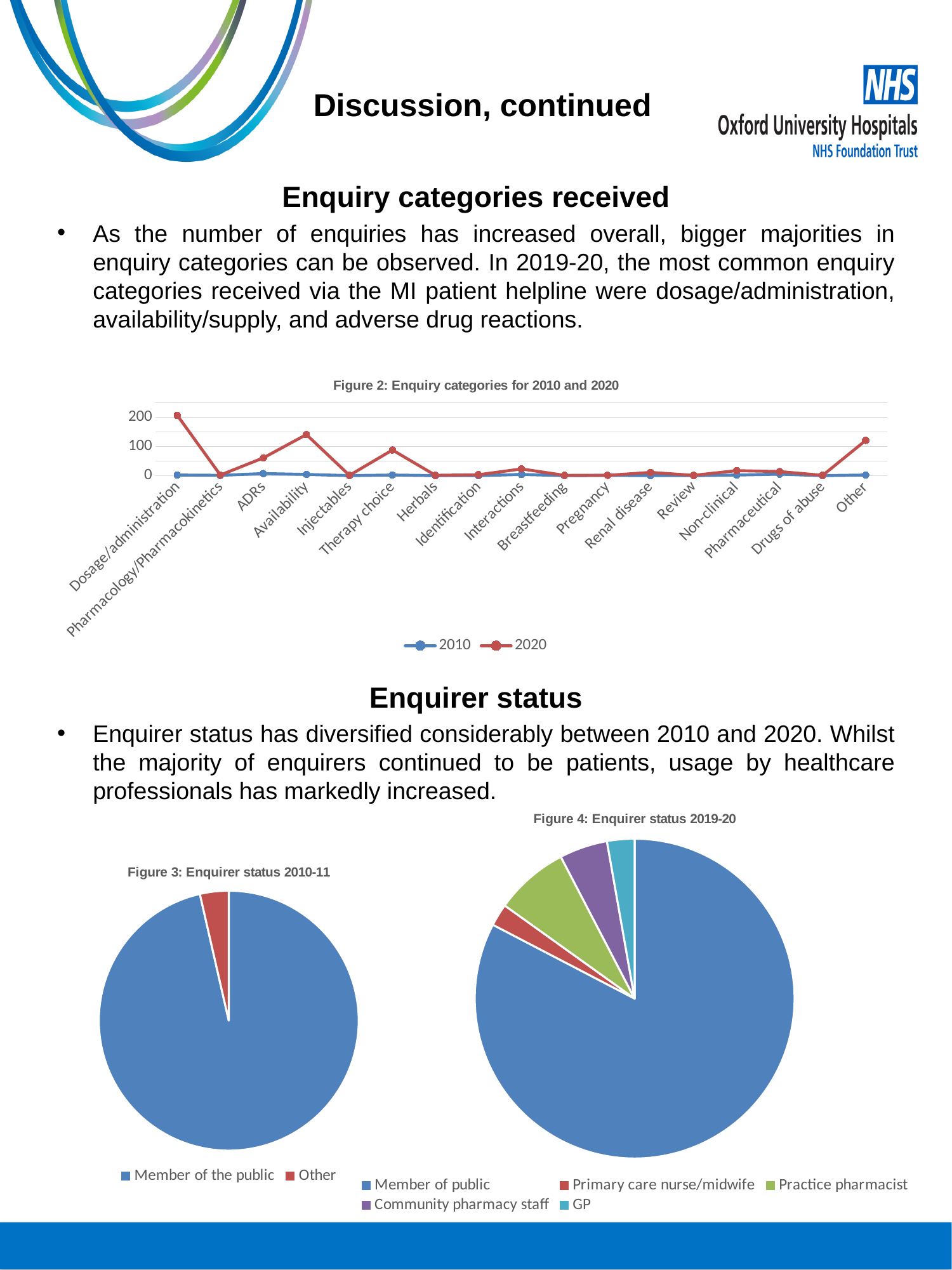
What kind of chart is Figure 3: Enquirer status 2010-11? Pie chart In Figure 4: Enquirer status 2019-20, which slice is larger: Practice pharmacist or Community pharmacy staff? Practice pharmacist In Figure 2: Enquiry categories for 2010 and 2020, is the 2020 value for Availability greater or less than 100? greater In Figure 2: Enquiry categories for 2010 and 2020, is the 2020 value for Pharmacology/Pharmacokinetics greater or less than 100? less What kind of chart is Figure 2: Enquiry categories for 2010 and 2020? Line chart In Figure 2: Enquiry categories for 2010 and 2020, how many series does the legend list? 2 In Figure 2: Enquiry categories for 2010 and 2020, how many enquiry categories are shown on the x axis? 17 In Figure 2: Enquiry categories for 2010 and 2020, which is larger for the 2020 series: Availability or Therapy choice? Availability In Figure 4: Enquirer status 2019-20, how many categories does the legend list? 5 In Figure 2: Enquiry categories for 2010 and 2020, which series has the larger value for Dosage/administration: 2010 or 2020? 2020 In Figure 3: Enquirer status 2010-11, which category has the largest slice? Member of the public In Figure 2: Enquiry categories for 2010 and 2020, which category has the highest value for the 2020 series? Dosage/administration